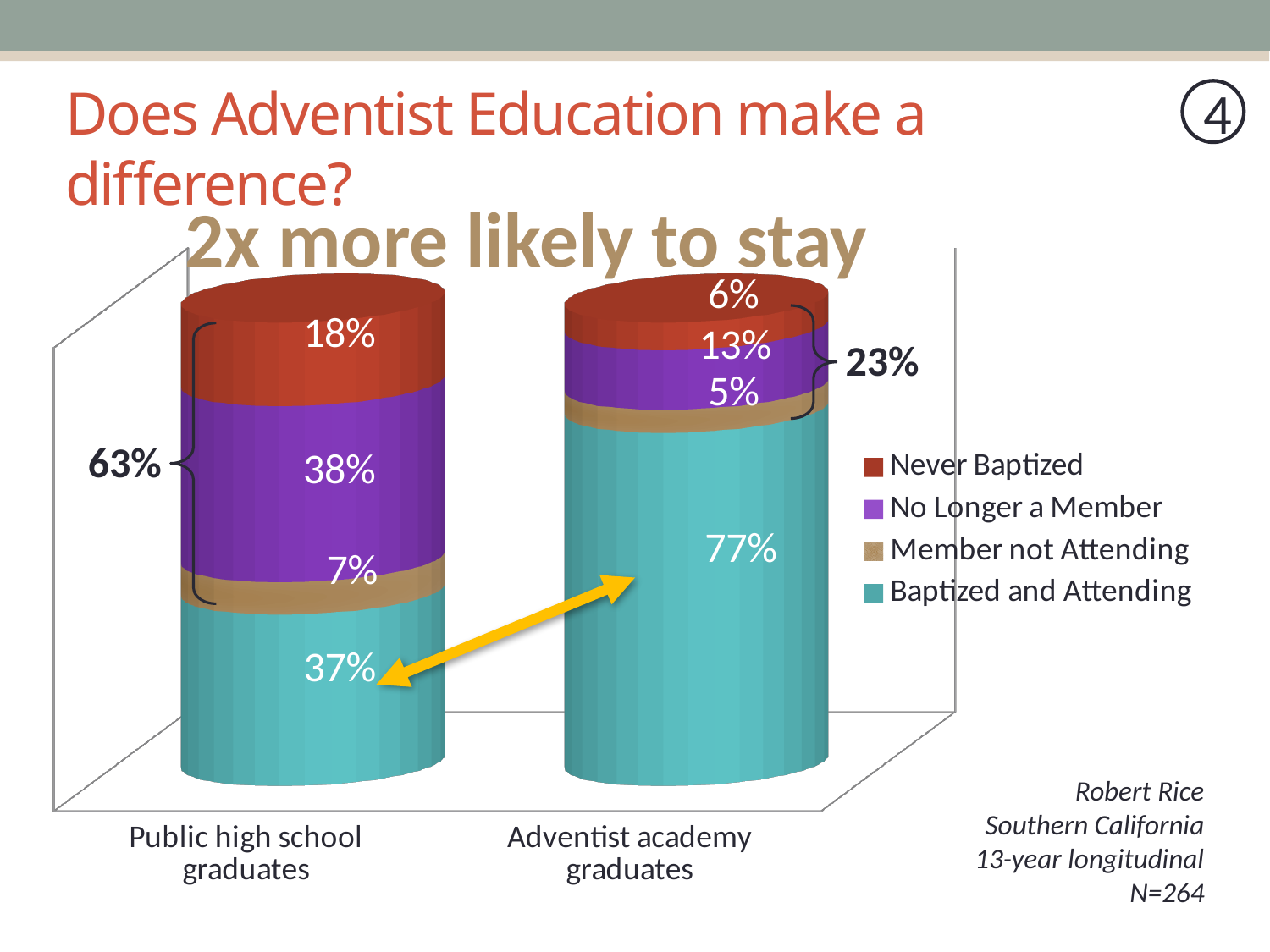
How many categories are shown on the x axis? 2 What type of chart is shown on the slide? Stacked bar chart Which series is the largest segment for public high school graduates? No Longer a Member What percentage of public high school graduates are Baptized and Attending? 37% How many series does the legend list? 4 What percentage of Adventist academy graduates are Baptized and Attending? 77% Which series is the smallest segment for Adventist academy graduates? Member not Attending What percentage of Adventist academy graduates are Member not Attending? 5% What is the difference between the Baptized and Attending percentages for Adventist academy graduates and public high school graduates? 40% What percentage of public high school graduates are No Longer a Member? 38% Which group has the higher Never Baptized percentage, public high school graduates or Adventist academy graduates? Public high school graduates What percentage of Adventist academy graduates were Never Baptized? 6%